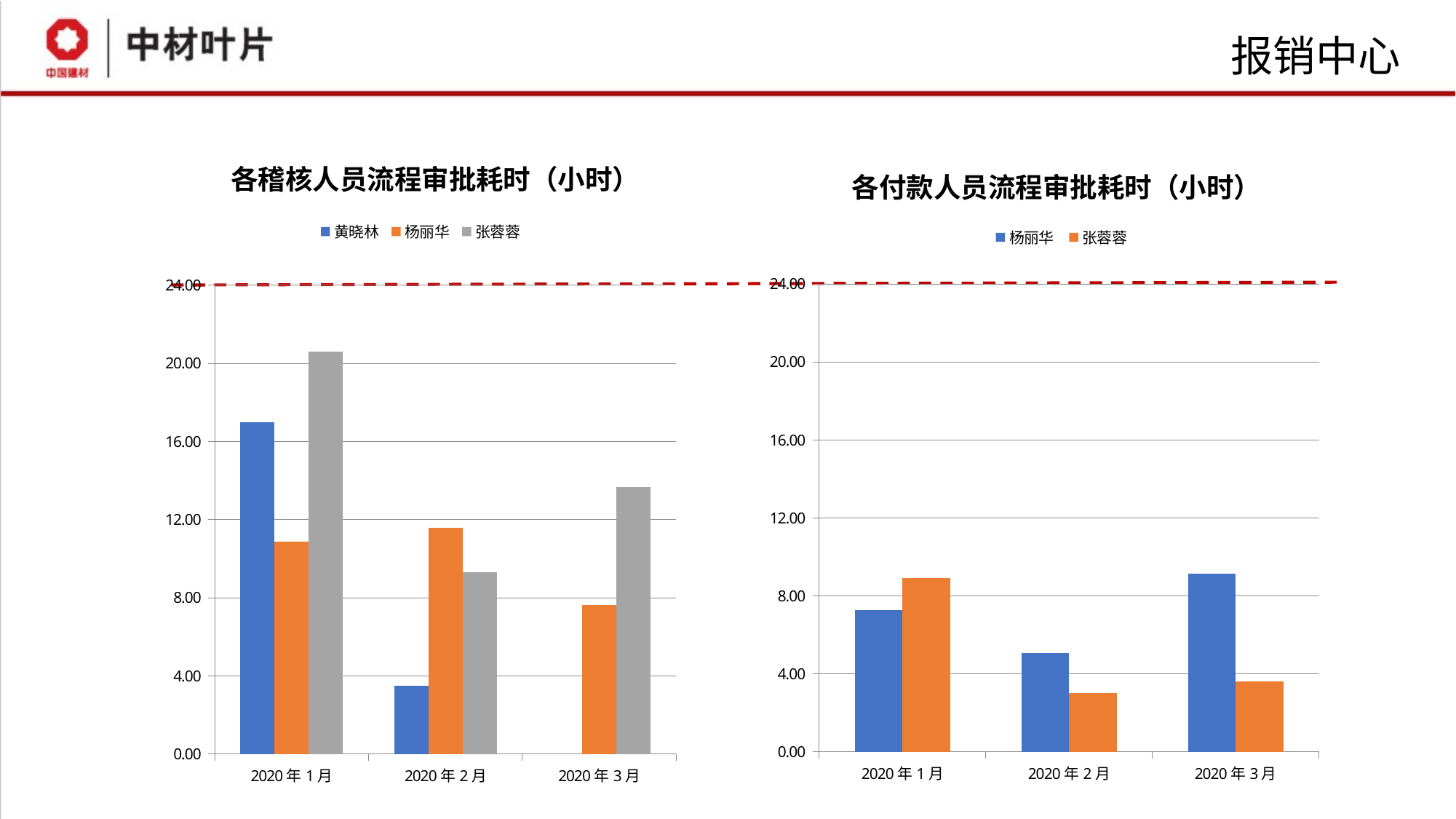
What value does the red dashed line mark on the y axis of both charts? 24.00 How many series does the legend of the right chart (各付款人员流程审批耗时) list? 2 How many series does the legend of the left chart (各稽核人员流程审批耗时) list? 3 In the left chart (各稽核人员流程审批耗时), is the value for 张蓉蓉 in 2020年1月 greater or less than 20.00? greater In the left chart (各稽核人员流程审批耗时), which series has the highest bar in 2020年1月? 张蓉蓉 In the right chart (各付款人员流程审批耗时), in which month is the bar for 张蓉蓉 highest? 2020年1月 In the left chart (各稽核人员流程审批耗时), which series has the lowest bar in 2020年2月? 黄晓林 How many month categories are shown on the x axis of the right chart (各付款人员流程审批耗时)? 3 What kind of chart is the left chart titled 各稽核人员流程审批耗时（小时）? bar chart In the right chart (各付款人员流程审批耗时), is the value for 张蓉蓉 in 2020年1月 greater or less than 8.00? greater In the right chart (各付款人员流程审批耗时), which is larger in 2020年3月, 杨丽华 or 张蓉蓉? 杨丽华 In the left chart (各稽核人员流程审批耗时), is the value for 黄晓林 in 2020年2月 greater or less than 4.00? less